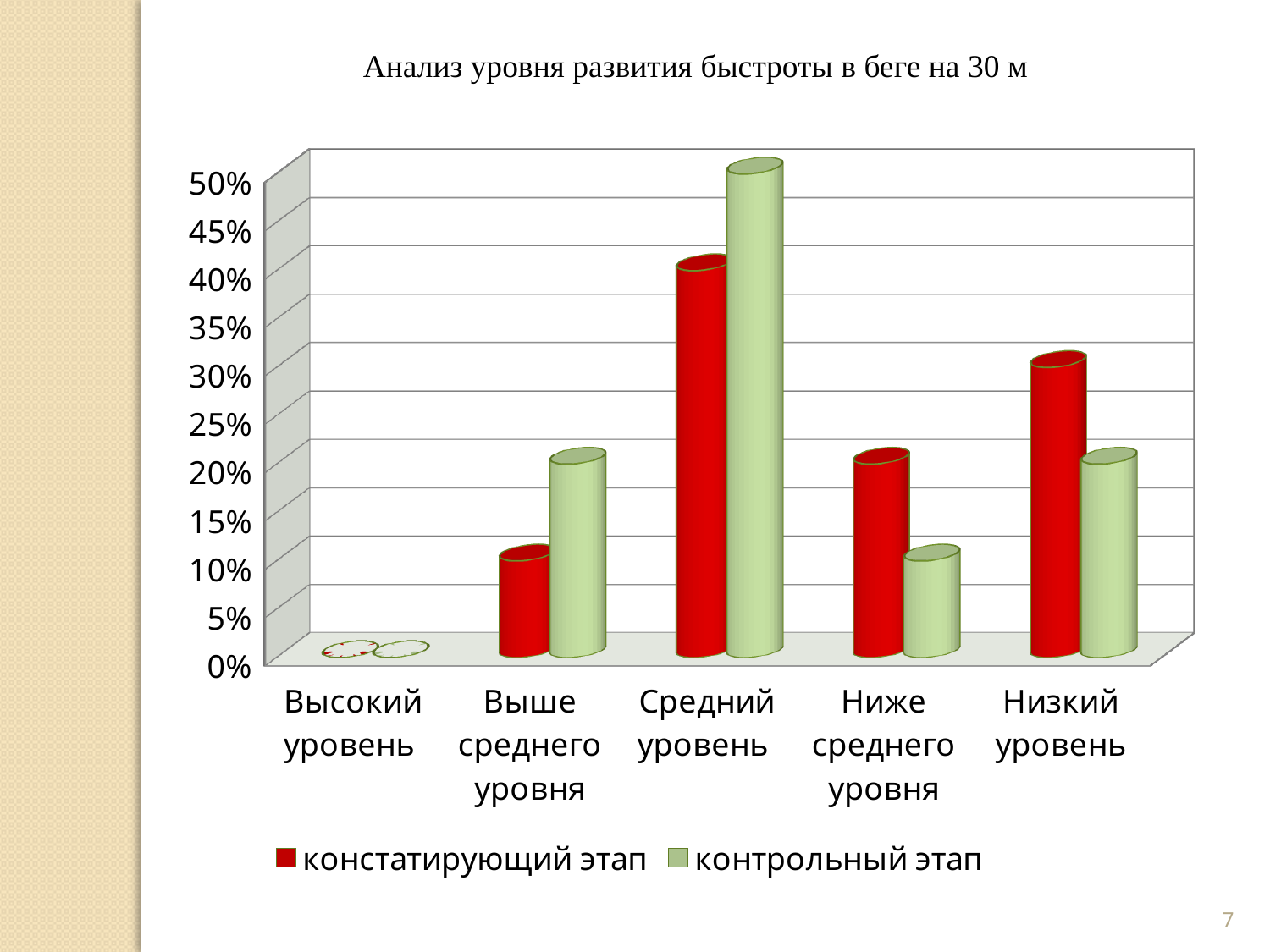
What kind of chart is shown on the slide? bar chart Is the value for Низкий уровень in the констатирующий этап series greater or less than 25%? greater Which series is shown in red? констатирующий этап What is the value for Высокий уровень in the констатирующий этап series? 0% How many categories are shown on the x axis? 5 How many series does the legend list? 2 What is the title of the chart? Анализ уровня развития быстроты в беге на 30 м For Ниже среднего уровня, which series has the larger value, констатирующий этап or контрольный этап? констатирующий этап Which category has the highest value for констатирующий этап? Средний уровень Which category has the lowest value for both series? Высокий уровень Is the value for Средний уровень in the контрольный этап series greater or less than 45%? greater Which category has the highest value for контрольный этап? Средний уровень